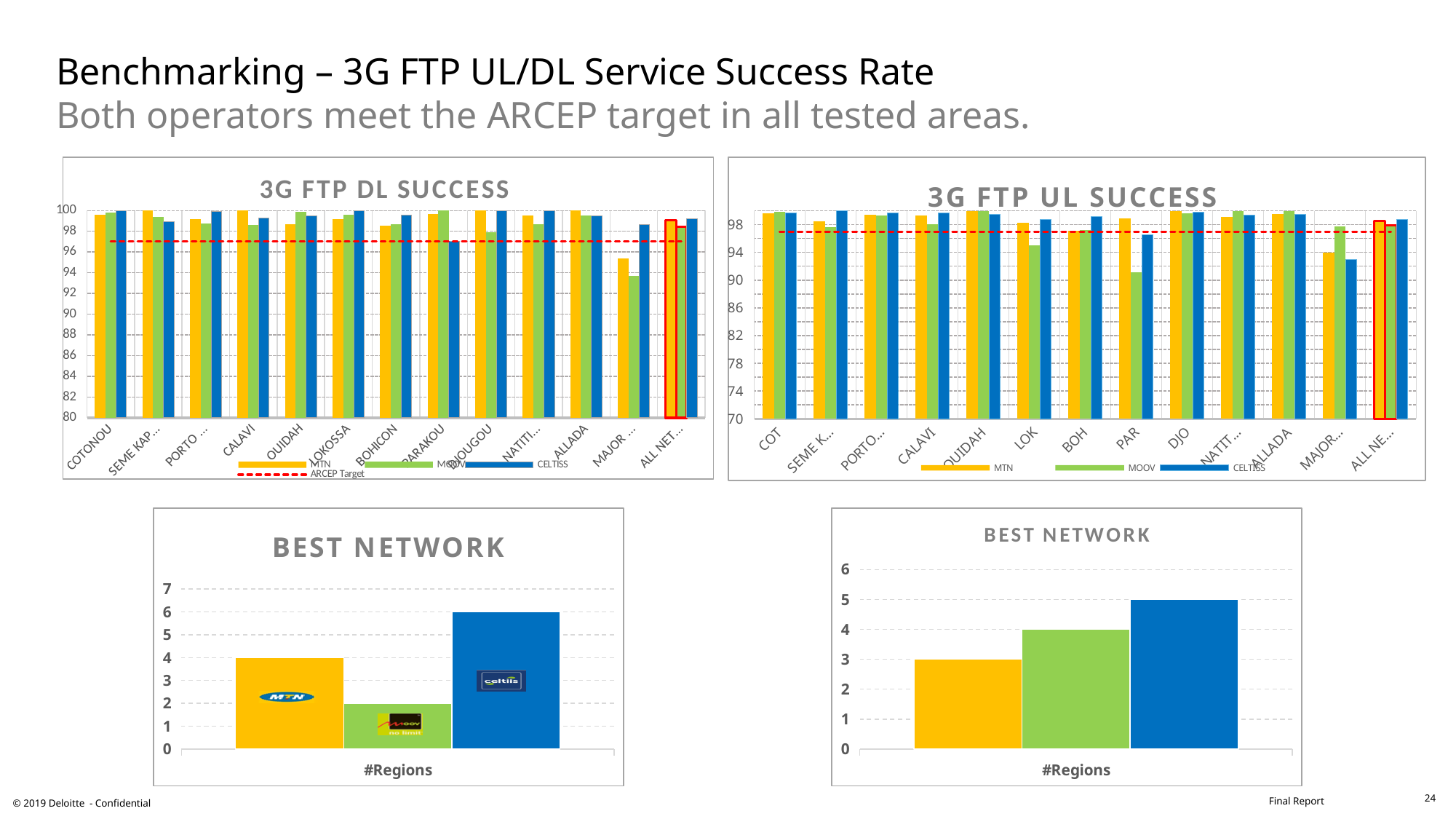
How many categories are shown on the x axis of the 3G FTP UL SUCCESS chart? 13 How many series does the legend of the 3G FTP DL SUCCESS chart list? 4 In the bottom-right BEST NETWORK chart, what is the value of the yellow bar? 3 In the bottom-left BEST NETWORK chart, what is the value for MOOV? 2 What kind of chart is the 3G FTP UL SUCCESS chart? combination bar and line chart In the bottom-right BEST NETWORK chart, which bar is the lowest? the yellow bar In the bottom-right BEST NETWORK chart, what is the value of the blue bar? 5 In the bottom-left BEST NETWORK chart, what is the difference between the CELTIIS value and the MTN value? 2 In the 3G FTP DL SUCCESS chart, which category has the lowest MOOV value? MAJOR In the 3G FTP UL SUCCESS chart, is the MOOV value for PAR greater or less than 94? less In the bottom-left BEST NETWORK chart, which network has the highest value? CELTIIS In the bottom-left BEST NETWORK chart, what is the value for MTN? 4